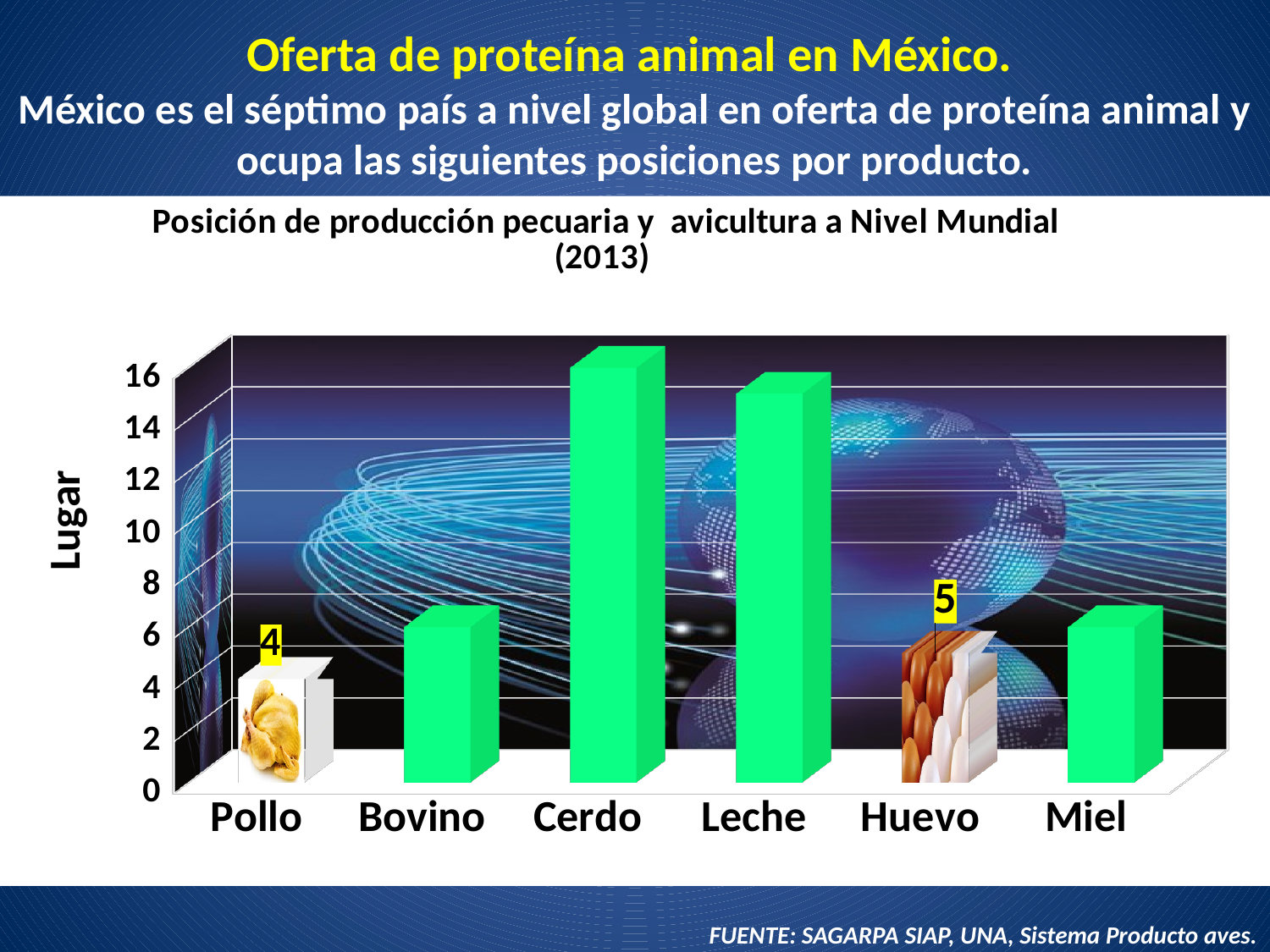
What is the value shown for Pollo? 4 What is the value shown for Huevo? 5 Is the value for Cerdo greater or less than 10? greater Which category has the tallest bar? Cerdo Which has a larger value, Pollo or Huevo? Huevo How many categories are shown on the x axis? 6 What is the label of the vertical axis? Lugar Which category has the lowest value? Pollo Which has a larger value, Cerdo or Bovino? Cerdo What is the difference between the values for Huevo and Pollo? 1 What kind of chart is shown on the slide? bar chart Is the value for Bovino greater or less than 10? less